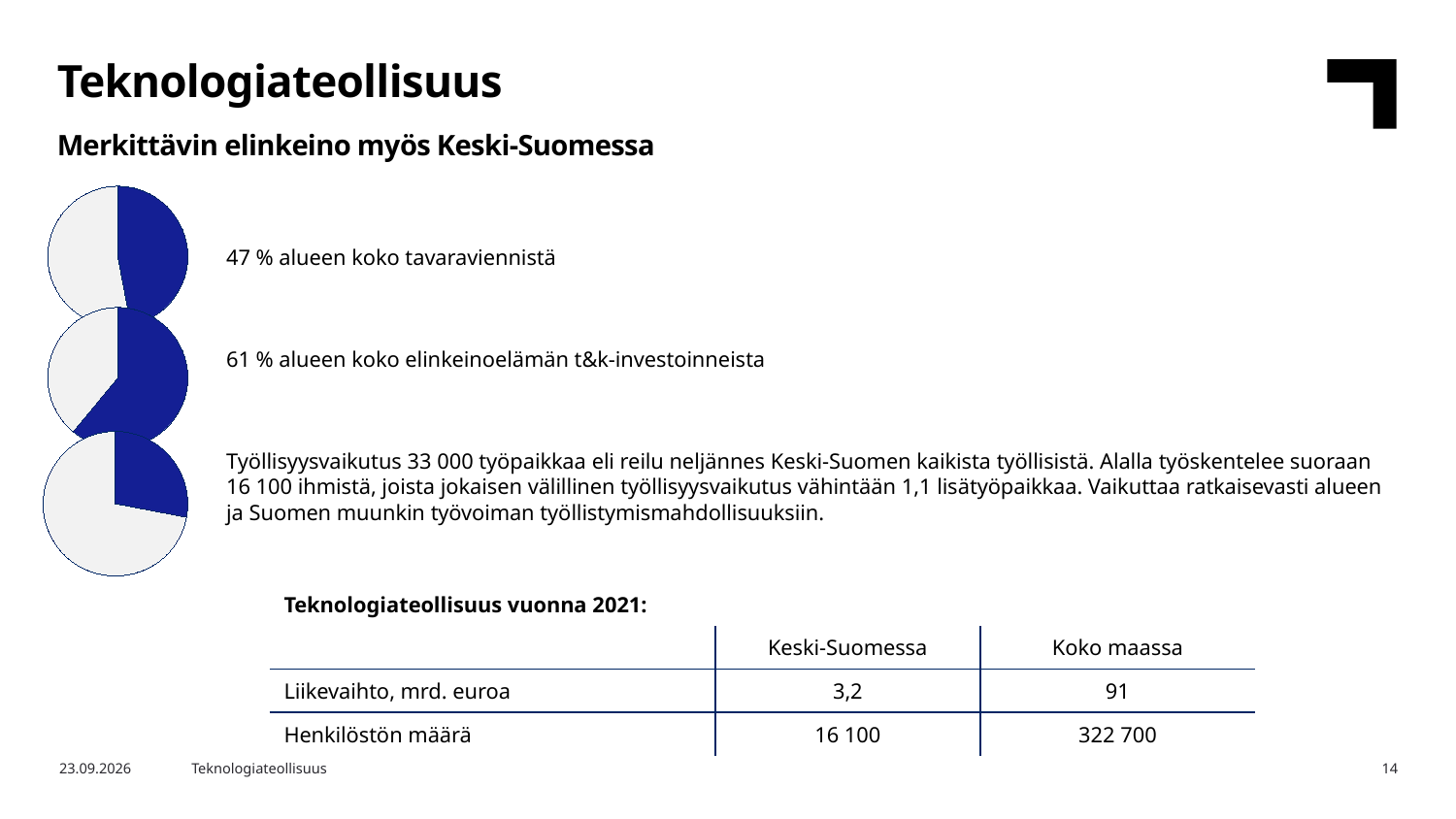
According to the text next to the top pie chart, what share of the region's total goods exports does the technology industry account for? 47 % Which pie chart has the larger blue slice, the top one (tavaravienti) or the middle one (t&k-investoinnit)? The middle one (t&k-investoinnit) Is the blue slice in the bottom pie chart more or less than half of the pie? Less Which pie chart has the smallest blue slice: the top, middle or bottom one? The bottom one What is the difference in percentage points between the share shown for the middle pie chart (61 %) and the top pie chart (47 %)? 14 percentage points According to the text next to the middle pie chart, what share of the region's business R&D investments does the technology industry account for? 61 % What kind of charts are shown on the left side of the slide? Pie charts How many pie charts are on the slide? 3 What is the title of the slide containing the pie charts? Teknologiateollisuus What colour is used for the highlighted slice in each pie chart? Blue Which pie chart has the largest blue slice: the top, middle or bottom one? The middle one